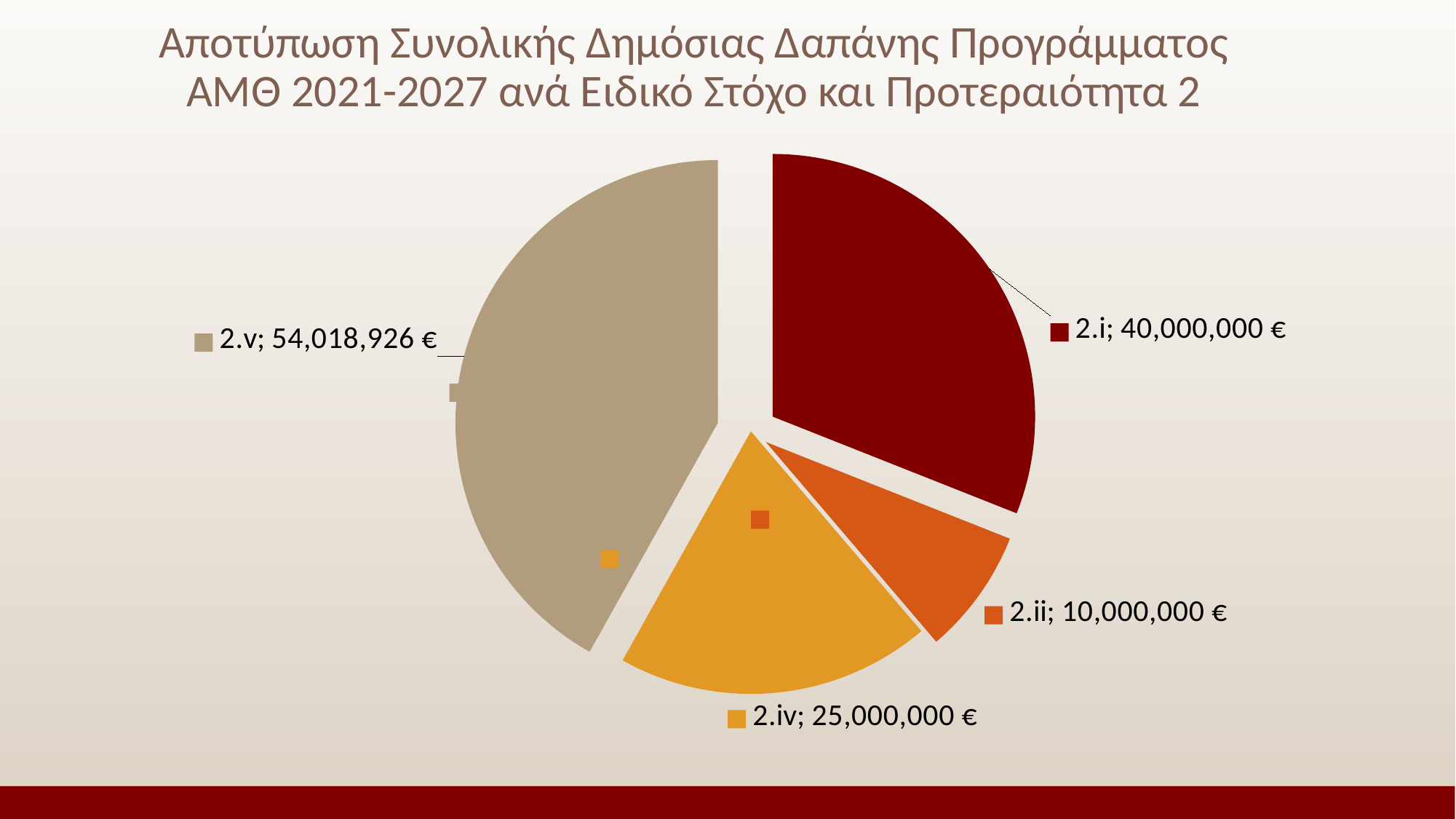
What is the value for 2.ii? 10,000,000 € What kind of chart is shown on the slide? Pie chart What is the value for 2.i? 40,000,000 € How many slices does the pie chart have? 4 What is the value for 2.v? 54,018,926 € What is the total of all four slices in the pie chart? 129,018,926 € What is the value for 2.iv? 25,000,000 € Which is larger, the value for 2.i or the value for 2.iv? 2.i Which category has the smallest slice? 2.ii Which category has the largest slice? 2.v What is the title of the chart? Αποτύπωση Συνολικής Δημόσιας Δαπάνης Προγράμματος ΑΜΘ 2021-2027 ανά Ειδικό Στόχο και Προτεραιότητα 2 What is the difference between the values for 2.v and 2.i? 14,018,926 €